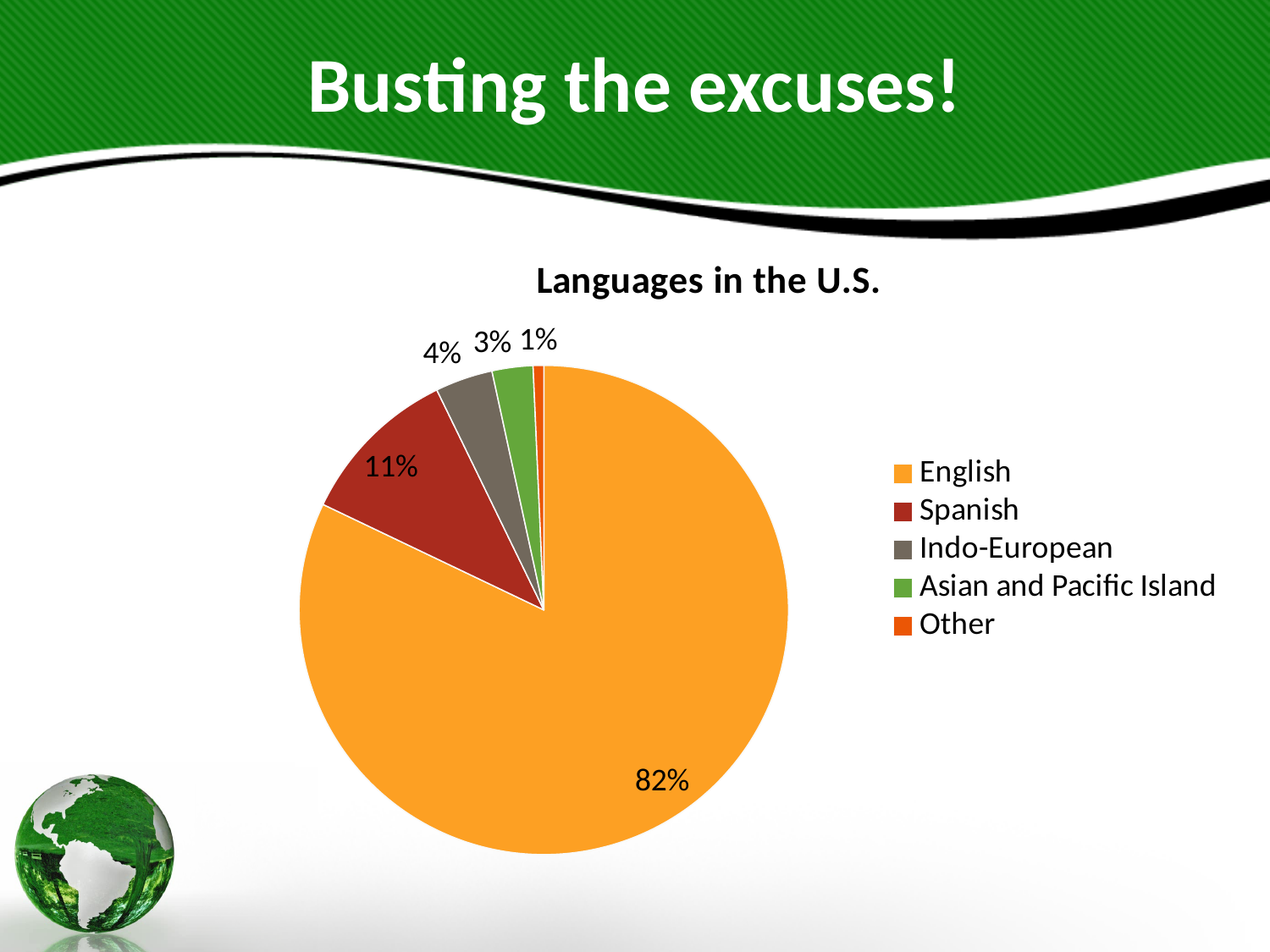
Which language category has the largest share of the pie? English What percentage of the pie is Other? 1% What percentage of the pie is Spanish? 11% What percentage of the pie is Asian and Pacific Island? 3% Which is larger, the share for Indo-European or the share for Asian and Pacific Island? Indo-European What percentage of the pie is English? 82% What is the difference in percentage points between English and Spanish? 71 Which language category has the smallest share of the pie? Other What kind of chart is shown on the slide? pie chart How many categories does the legend list? 5 What percentage of the pie is Indo-European? 4% What is the title of the chart? Languages in the U.S.